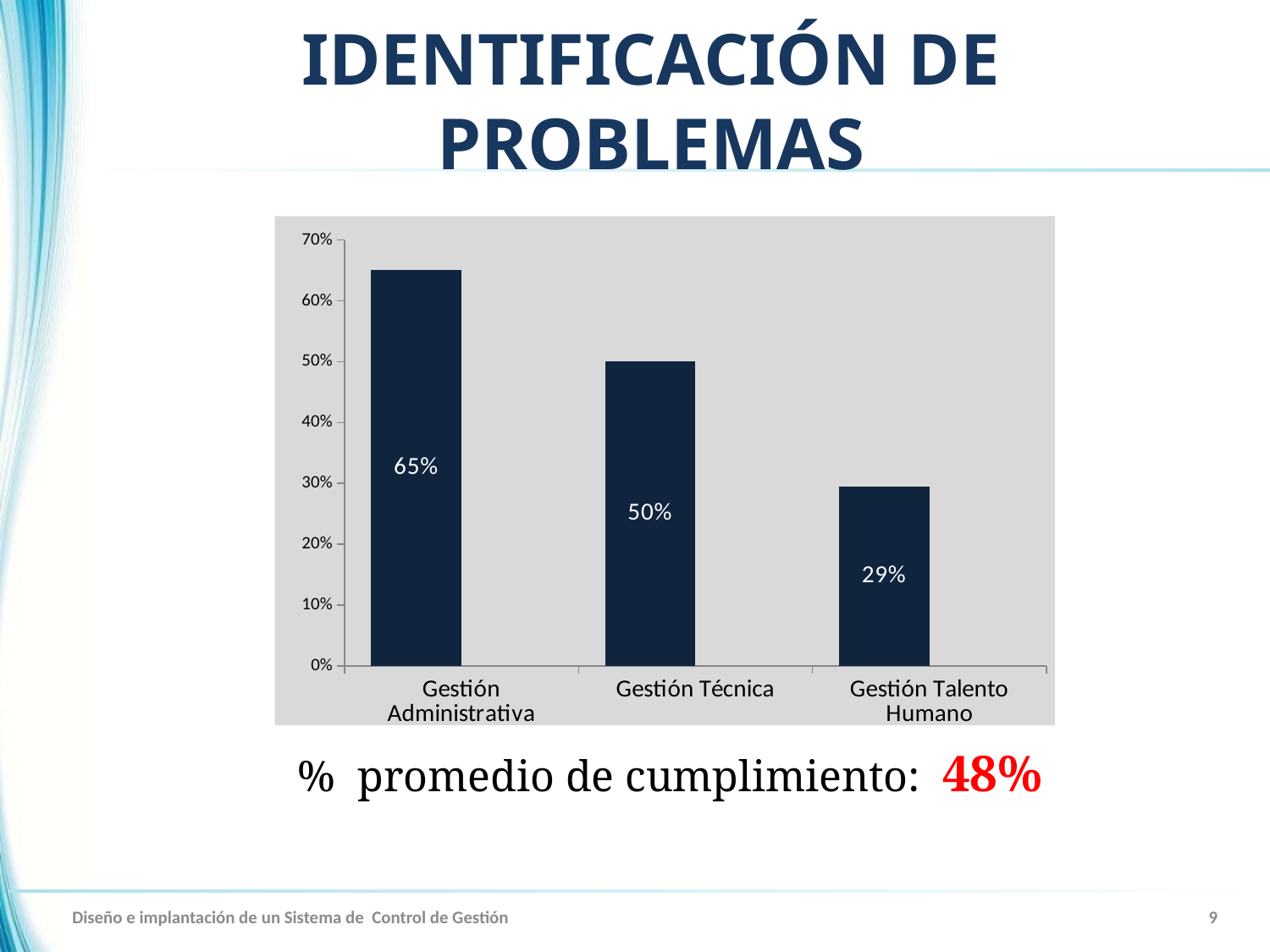
Which category has the highest value? Gestión Administrativa Is the value for Gestión Administrativa greater or less than 60%? greater What is the difference between the values for Gestión Administrativa and Gestión Talento Humano? 36% How many categories are shown in the chart? 3 Do the values rise or fall from left to right across the categories? fall What kind of chart is shown on the slide? bar chart What is the value for Gestión Talento Humano? 29% What is the difference between the values for Gestión Técnica and Gestión Talento Humano? 21% Which category has the lowest value? Gestión Talento Humano What is the value for Gestión Administrativa? 65% What is the value for Gestión Técnica? 50% Which is larger, the value for Gestión Técnica or the value for Gestión Talento Humano? Gestión Técnica